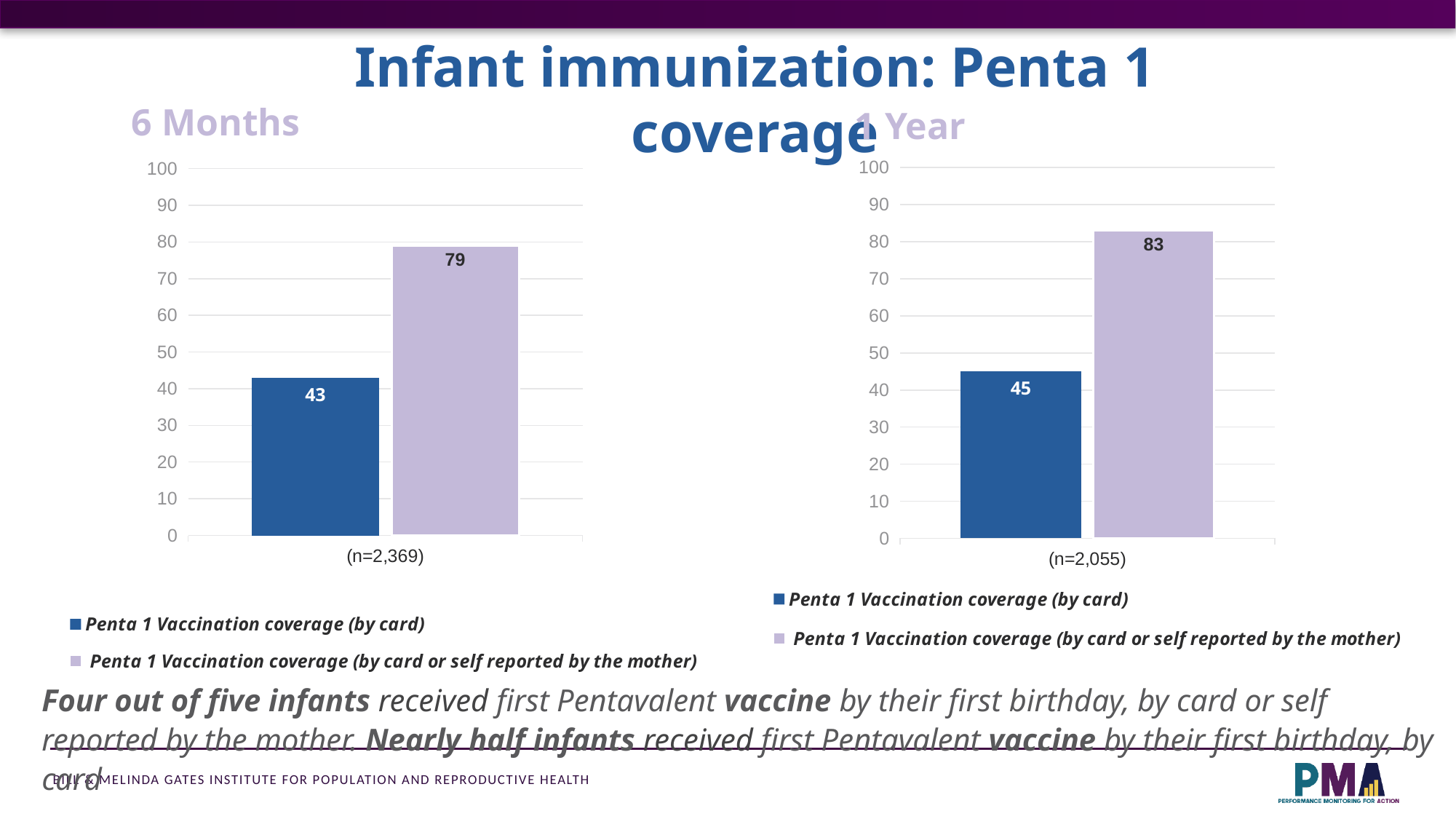
In the 1 Year chart, what is the difference between the by card or self reported value and the by card value? 38 In the 6 Months chart, what is the difference between the by card or self reported value and the by card value? 36 Is the by card value in the 1 Year chart larger or smaller than the by card value in the 6 Months chart? larger In the 1 Year chart, what is the value for Penta 1 Vaccination coverage (by card)? 45 What is the sample size shown on the x axis of the 6 Months chart? (n=2,369) In the 1 Year chart, which series has the higher value? Penta 1 Vaccination coverage (by card or self reported by the mother) In the 6 Months chart, what is the value for Penta 1 Vaccination coverage (by card)? 43 How many series does the legend of the 6 Months chart list? 2 In the 6 Months chart, what is the value for Penta 1 Vaccination coverage (by card or self reported by the mother)? 79 In the 6 Months chart, which series has the lower value? Penta 1 Vaccination coverage (by card) What kind of chart is the 1 Year chart? bar chart In the 1 Year chart, what is the value for Penta 1 Vaccination coverage (by card or self reported by the mother)? 83